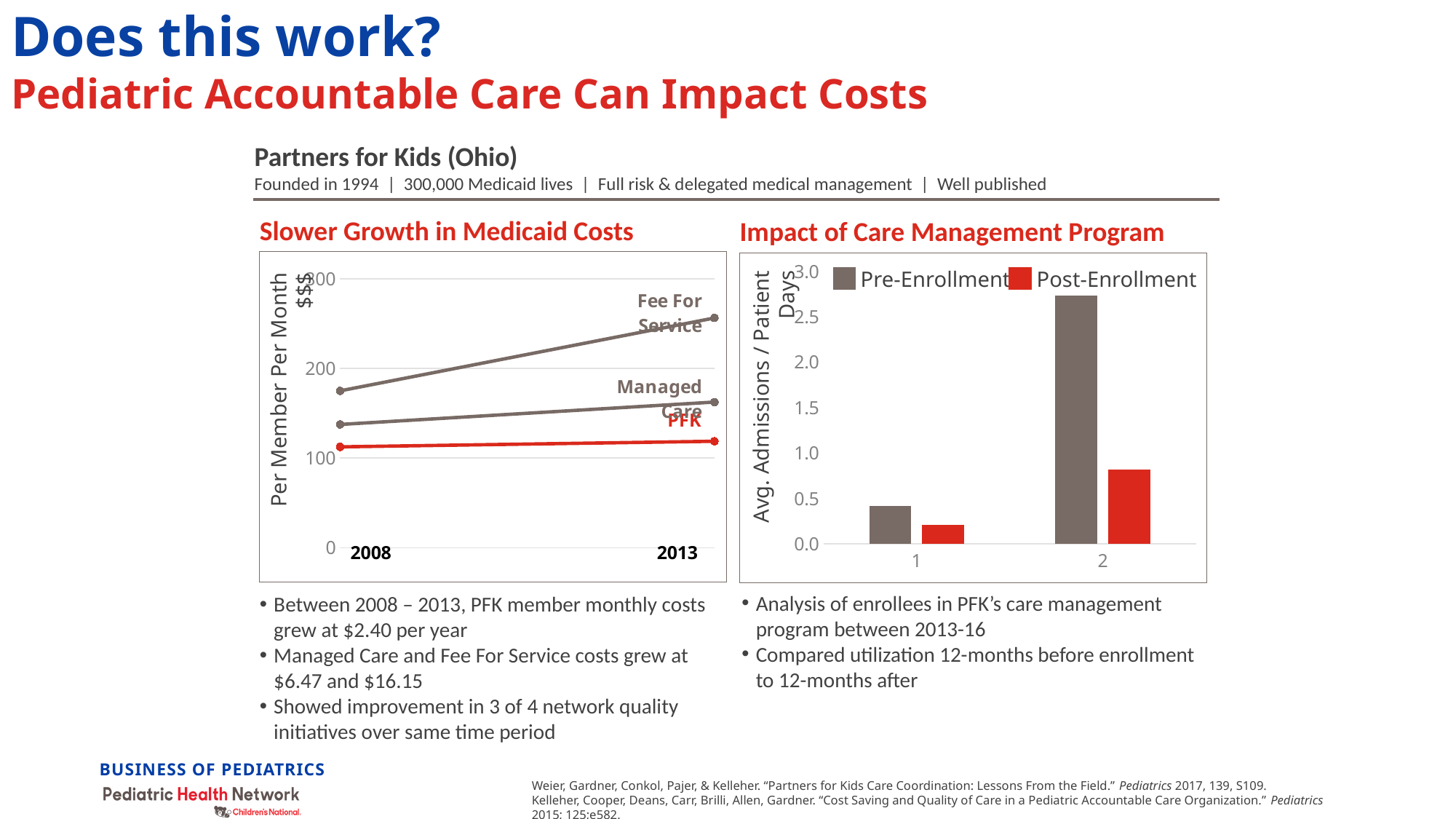
In the "Impact of Care Management Program" chart, is the Pre-Enrollment bar for category 2 greater or less than 2.5? greater What kind of chart is the "Slower Growth in Medicaid Costs" chart? line chart In the "Slower Growth in Medicaid Costs" chart, how many lines are plotted? 3 In the "Impact of Care Management Program" chart, which is larger for category 1: Pre-Enrollment or Post-Enrollment? Pre-Enrollment In the "Impact of Care Management Program" chart, what colour are the Post-Enrollment bars? red In the "Impact of Care Management Program" chart, how many series does the legend list? 2 In the "Slower Growth in Medicaid Costs" chart, does the Fee For Service line rise or fall from 2008 to 2013? rise In the "Slower Growth in Medicaid Costs" chart, which line is highest in 2013? Fee For Service In the "Slower Growth in Medicaid Costs" chart, is the PFK value in 2013 greater or less than 200? less What kind of chart is the "Impact of Care Management Program" chart? bar chart In the "Slower Growth in Medicaid Costs" chart, which line is lowest in 2008? PFK In the "Slower Growth in Medicaid Costs" chart, is the Fee For Service value in 2013 greater or less than 200? greater